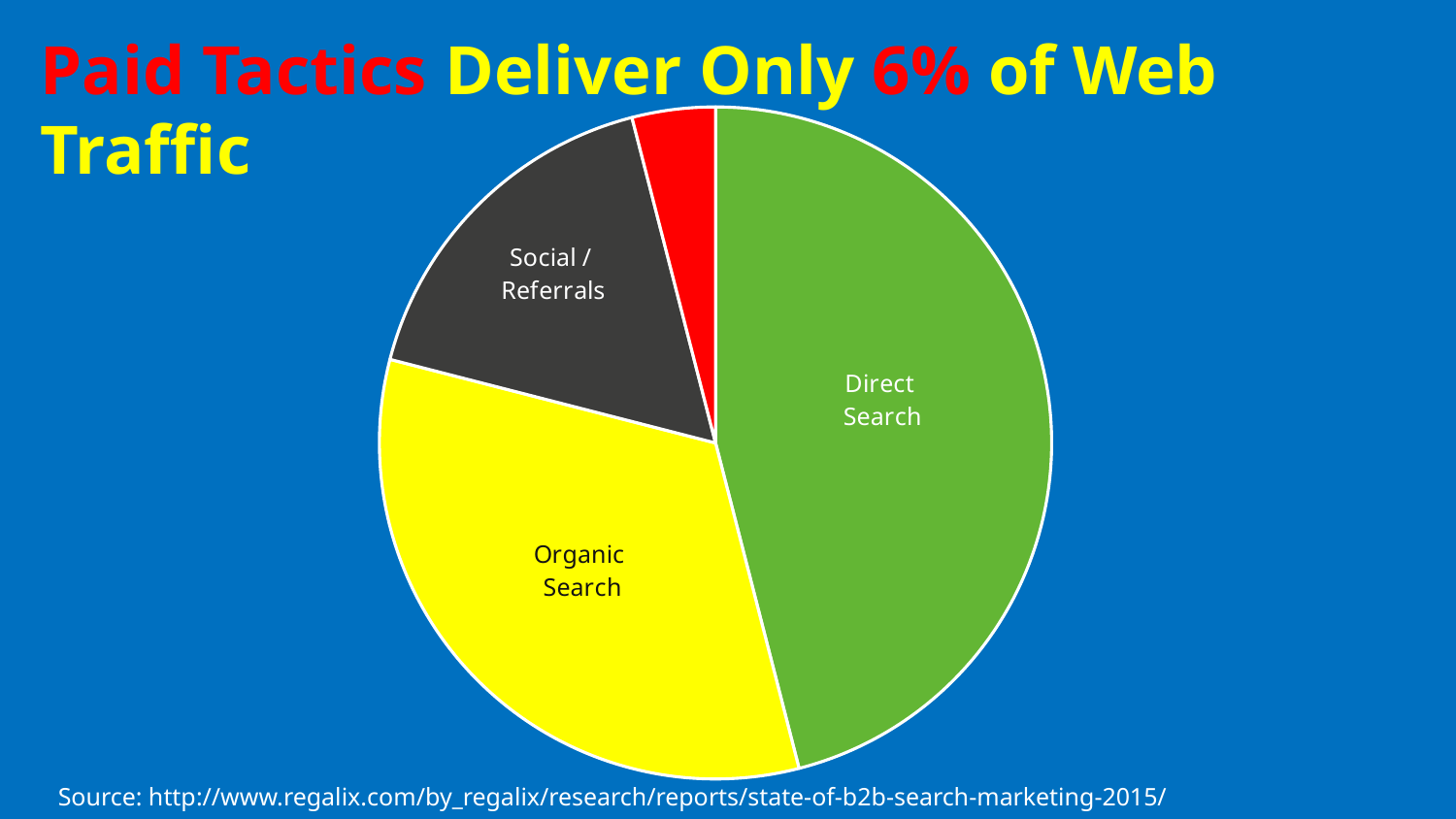
Which is larger, the Direct Search slice or the Organic Search slice? Direct Search What is the title of the slide containing the pie chart? Paid Tactics Deliver Only 6% of Web Traffic What kind of chart is shown on the slide? pie chart How many slices does the pie chart have? 4 Which is larger, the Direct Search slice or the Social / Referrals slice? Direct Search Which category has the largest slice of the pie chart? Direct Search What colour is the Direct Search slice? green Does the Direct Search slice account for more or less than half of the pie? less